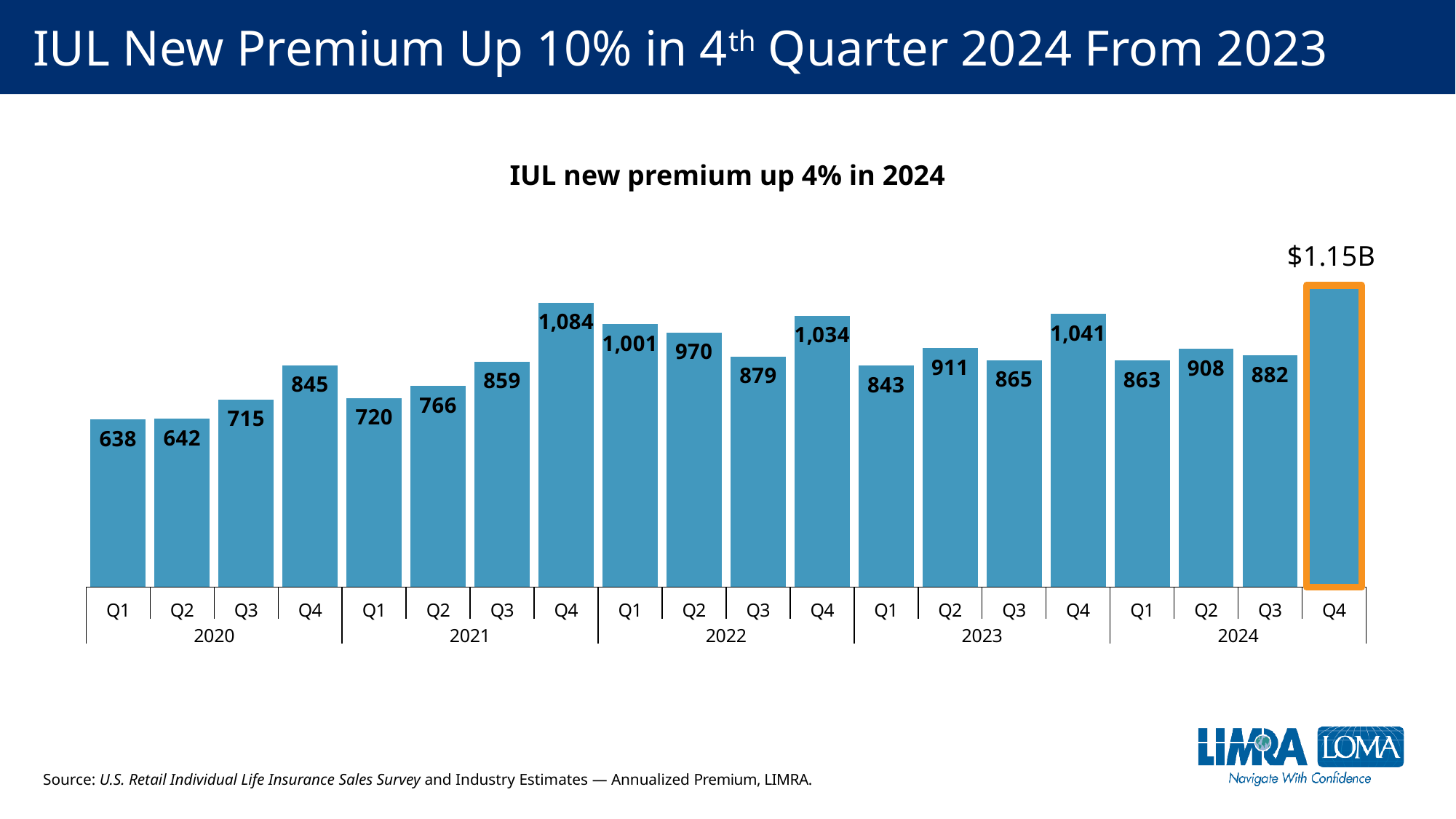
What is the value for Q4 2021? 1,084 Which quarter has the highest value? Q4 2024 What is the difference between the values for Q4 2023 and Q4 2022? 7 What is the value for Q2 2023? 911 What is the value for Q4 2024? $1.15B Which is larger, the value for Q2 2022 or Q3 2022? Q2 2022 How many bars are plotted in the chart? 20 What is the value for Q1 2020? 638 What is the difference between the values for Q4 2021 and Q1 2021? 364 Which quarter has the lowest value? Q1 2020 What kind of chart is shown? Bar chart Do the values rise or fall across the four quarters of 2020? Rise